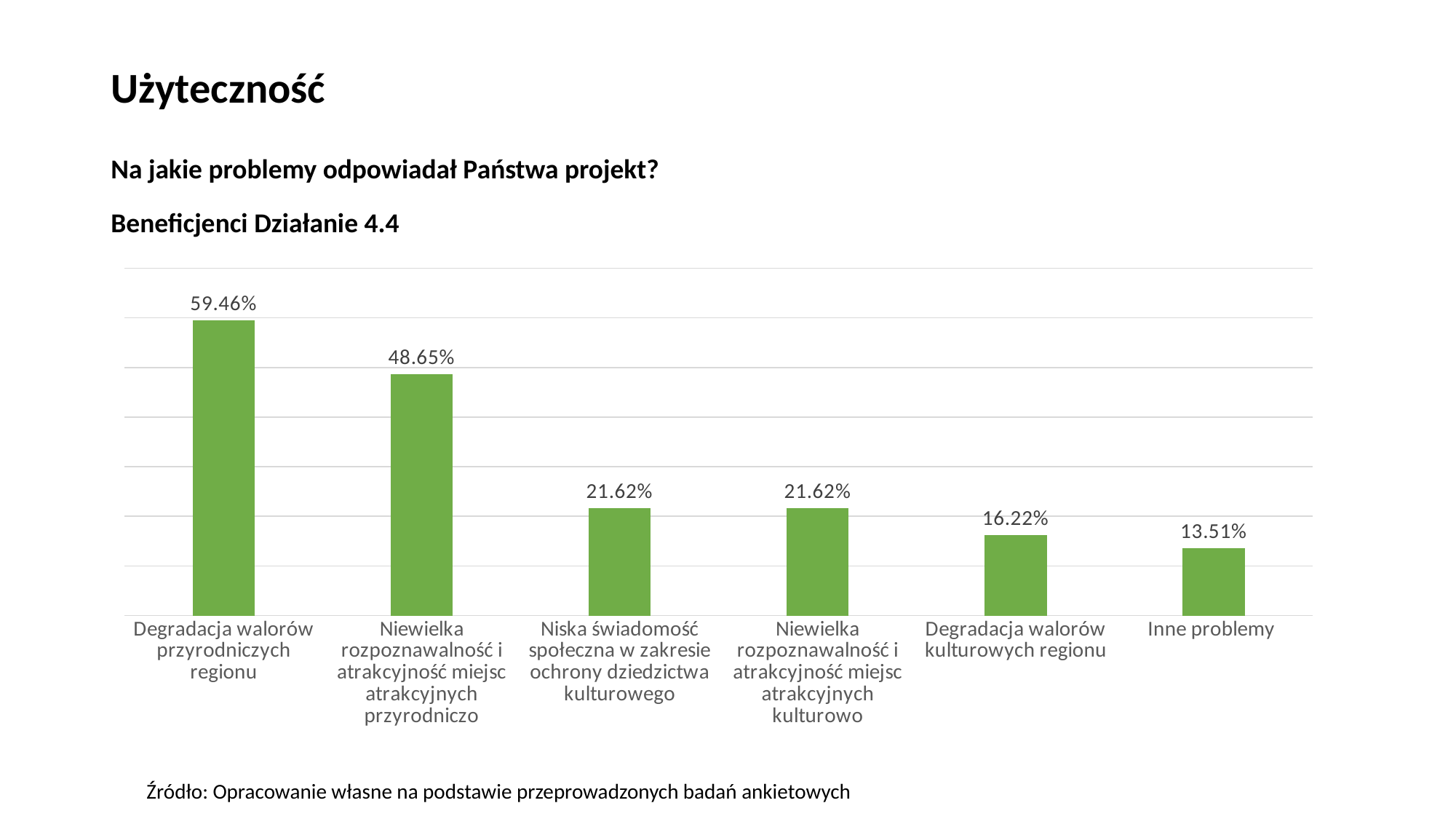
What is the difference between the values for "Degradacja walorów przyrodniczych regionu" and "Niewielka rozpoznawalność i atrakcyjność miejsc atrakcyjnych przyrodniczo"? 10.81% What is the value for "Degradacja walorów kulturowych regionu"? 16.22% How many categories are shown in the chart? 6 Which is larger: the value for "Niska świadomość społeczna w zakresie ochrony dziedzictwa kulturowego" or the value for "Degradacja walorów kulturowych regionu"? Niska świadomość społeczna w zakresie ochrony dziedzictwa kulturowego Which category has the lowest value? Inne problemy What is the value for "Niewielka rozpoznawalność i atrakcyjność miejsc atrakcyjnych przyrodniczo"? 48.65% What is the difference between the values for "Degradacja walorów kulturowych regionu" and "Inne problemy"? 2.71% What is the value for "Inne problemy"? 13.51% What colour are the bars in the chart? Green Which category has the highest value? Degradacja walorów przyrodniczych regionu What kind of chart is shown on the slide? Bar chart What is the value for "Degradacja walorów przyrodniczych regionu"? 59.46%